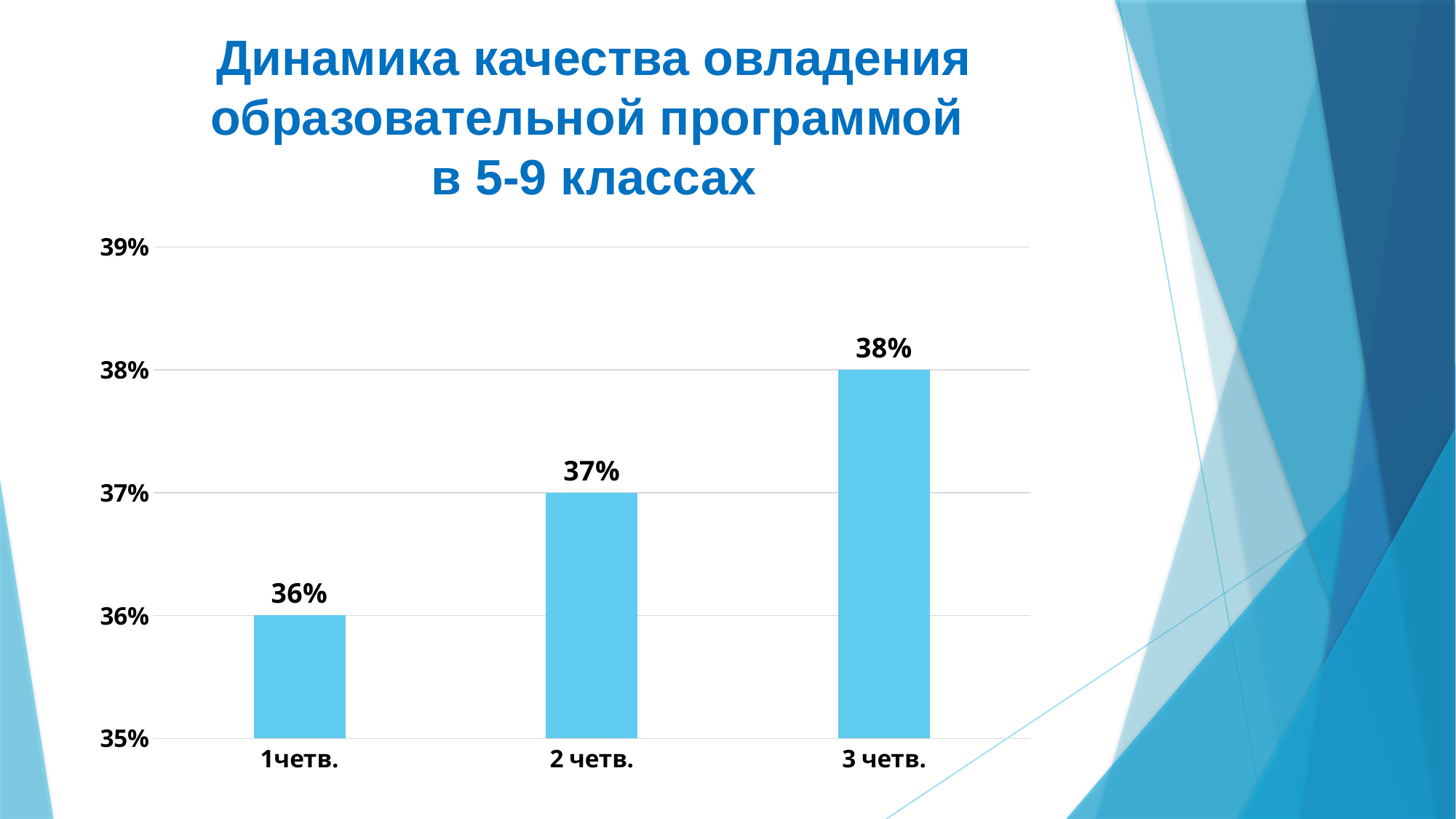
How many categories are shown on the x axis? 3 What is the difference between the values for 3 четв. and 1четв.? 2% Which category has the highest value? 3 четв. What is the value for 2 четв.? 37% Which is larger, the value for 2 четв. or the value for 3 четв.? 3 четв. Do the values rise or fall from 1четв. to 3 четв.? rise What is the difference between the values for 2 четв. and 1четв.? 1% What is the value for 3 четв.? 38% What is the value for 1четв.? 36% Which category has the lowest value? 1четв. Is the value for 3 четв. greater or less than 37%? greater What kind of chart is shown on the slide? bar chart